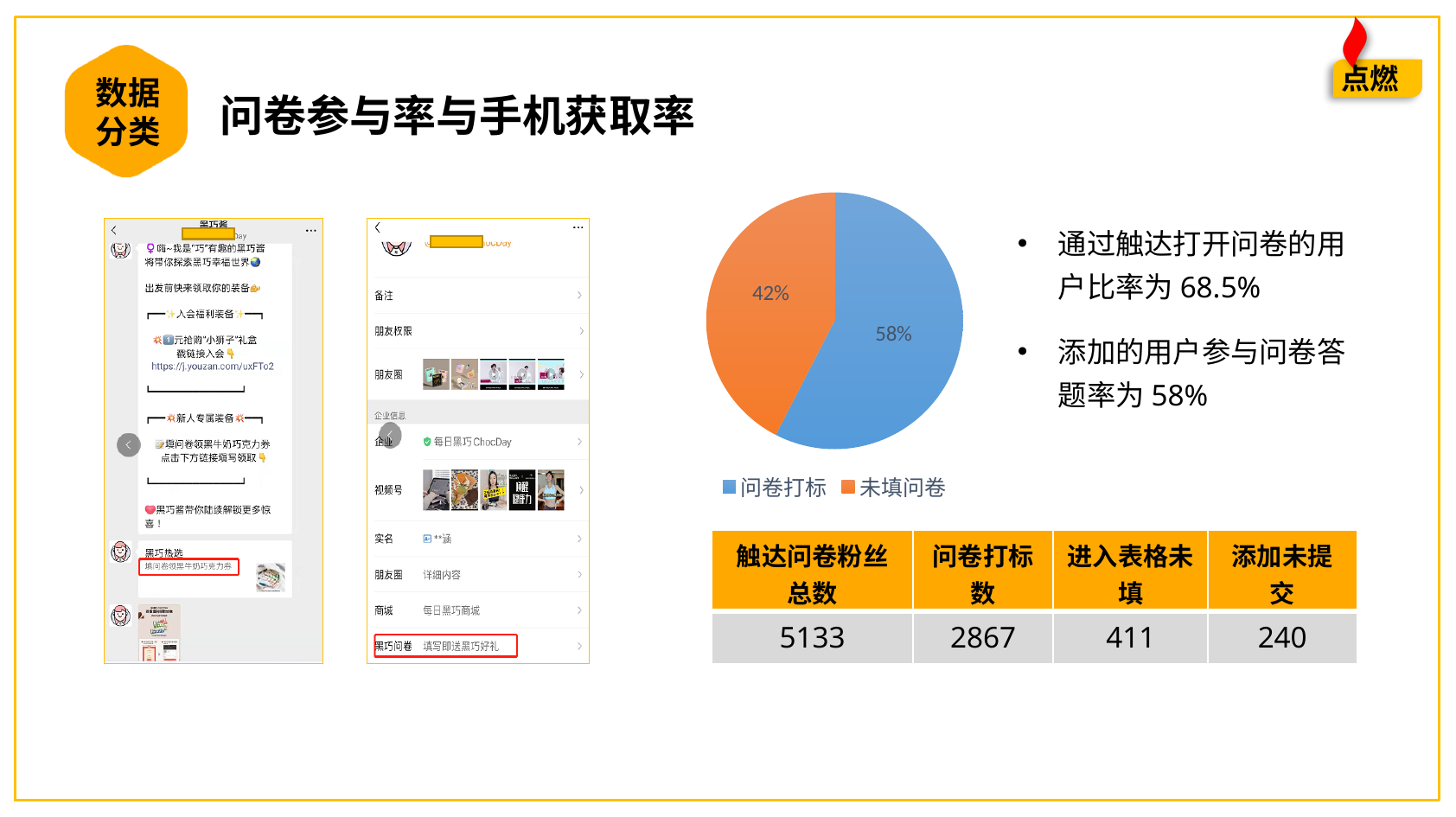
Which is larger, the 问卷打标 slice or the 未填问卷 slice? 问卷打标 How many slices does the pie chart have? 2 What is the difference in percentage points between the 问卷打标 slice and the 未填问卷 slice? 16 What colour is the 问卷打标 slice in the pie chart? blue Which slice of the pie chart is the largest? 问卷打标 What colour is the 未填问卷 slice in the pie chart? orange Is the share of the 未填问卷 slice greater or less than 50%? less What share of the pie does 未填问卷 represent? 42% How many entries does the legend of the pie chart list? 2 Which slice of the pie chart is the smallest? 未填问卷 What kind of chart is shown on the slide? pie chart What share of the pie does 问卷打标 represent? 58%